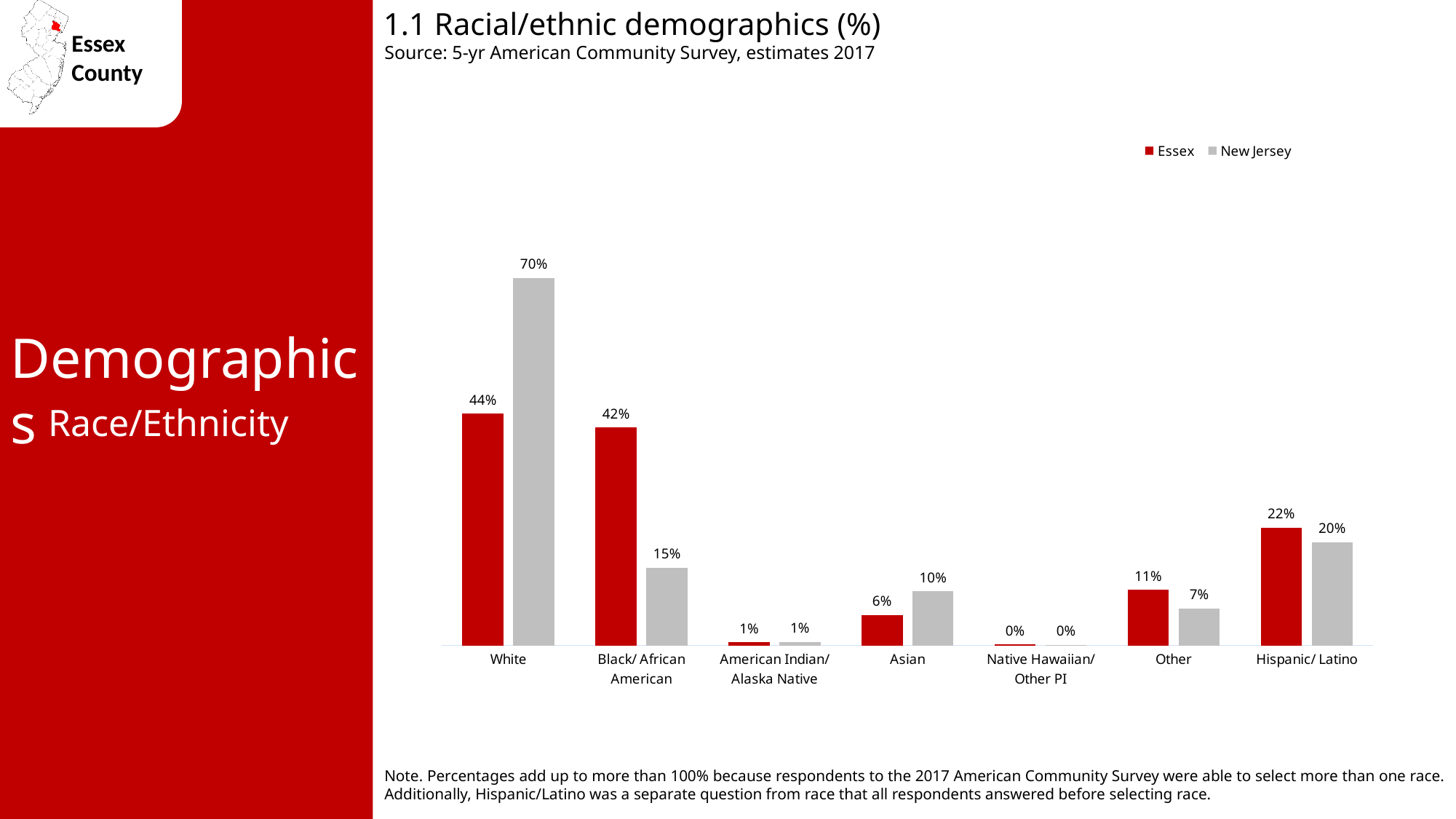
What is the New Jersey value for Black/ African American? 15% How many categories are shown on the x axis? 7 What is the Essex value for Hispanic/ Latino? 22% What kind of chart is shown? Bar chart Which is larger for Asian: the Essex value or the New Jersey value? New Jersey What is the difference between the New Jersey and Essex values for White? 26% Which is larger for Other: the Essex value or the New Jersey value? Essex Which category has the highest Essex value? White What is the difference between the Essex and New Jersey values for Black/ African American? 27% Which category has the highest New Jersey value? White What is the Essex value for White? 44% How many series does the legend list? 2